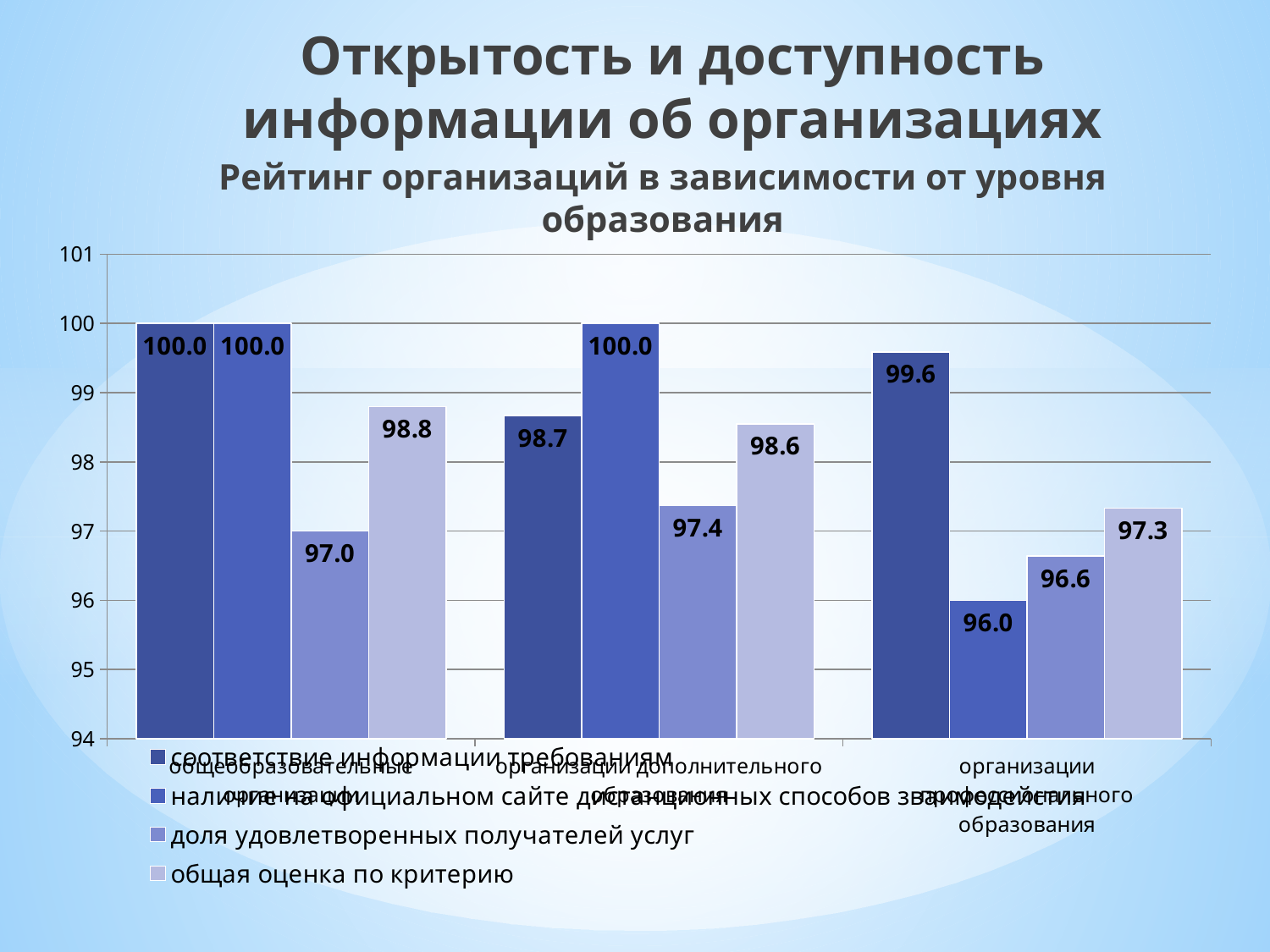
Which category has the highest value for 'общая оценка по критерию'? общеобразовательные организации What is the value of 'соответствие информации требованиям' for организации дополнительного образования? 98.7 What is the difference between 'соответствие информации требованиям' and 'наличие на официальном сайте дистанционных способов взаимодействия' for организации профессионального образования? 3.6 Is the value of 'доля удовлетворенных получателей услуг' for общеобразовательные организации greater or less than 98? less How many series does the legend list? 4 How many categories are shown on the x axis? 3 What is the value of 'общая оценка по критерию' for общеобразовательные организации? 98.8 What is the subtitle of the chart? Рейтинг организаций в зависимости от уровня образования What type of chart is shown on the slide? bar chart Which category has the lowest value for 'наличие на официальном сайте дистанционных способов взаимодействия'? организации профессионального образования Which is larger for организации дополнительного образования: 'доля удовлетворенных получателей услуг' or 'общая оценка по критерию'? общая оценка по критерию What is the value of 'доля удовлетворенных получателей услуг' for организации профессионального образования? 96.6